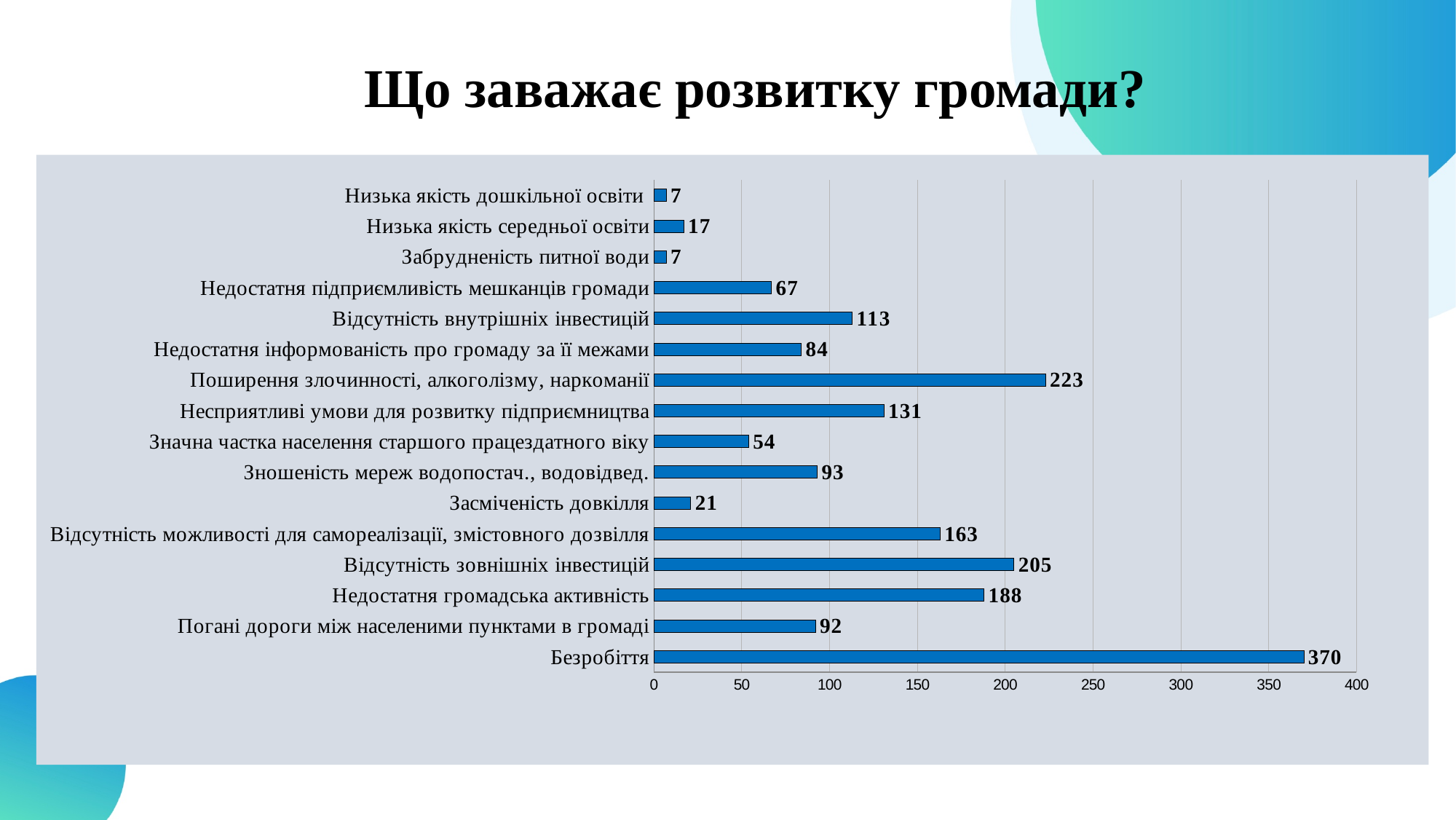
What type of chart is shown on the slide? Bar chart What is the value for Безробіття? 370 What is the title of the slide? Що заважає розвитку громади? Which is larger: the value for Відсутність внутрішніх інвестицій or the value for Недостатня підприємливість мешканців громади? Відсутність внутрішніх інвестицій What is the difference between the values for Відсутність зовнішніх інвестицій and Недостатня громадська активність? 17 What is the value for Засміченість довкілля? 21 Is the value for Відсутність можливості для самореалізації, змістовного дозвілля greater or less than 150? greater How many categories are plotted in the chart? 16 What is the value for Поширення злочинності, алкоголізму, наркоманії? 223 Which category has the highest value? Безробіття What is the value for Відсутність зовнішніх інвестицій? 205 What is the difference between the values for Безробіття and Поширення злочинності, алкоголізму, наркоманії? 147